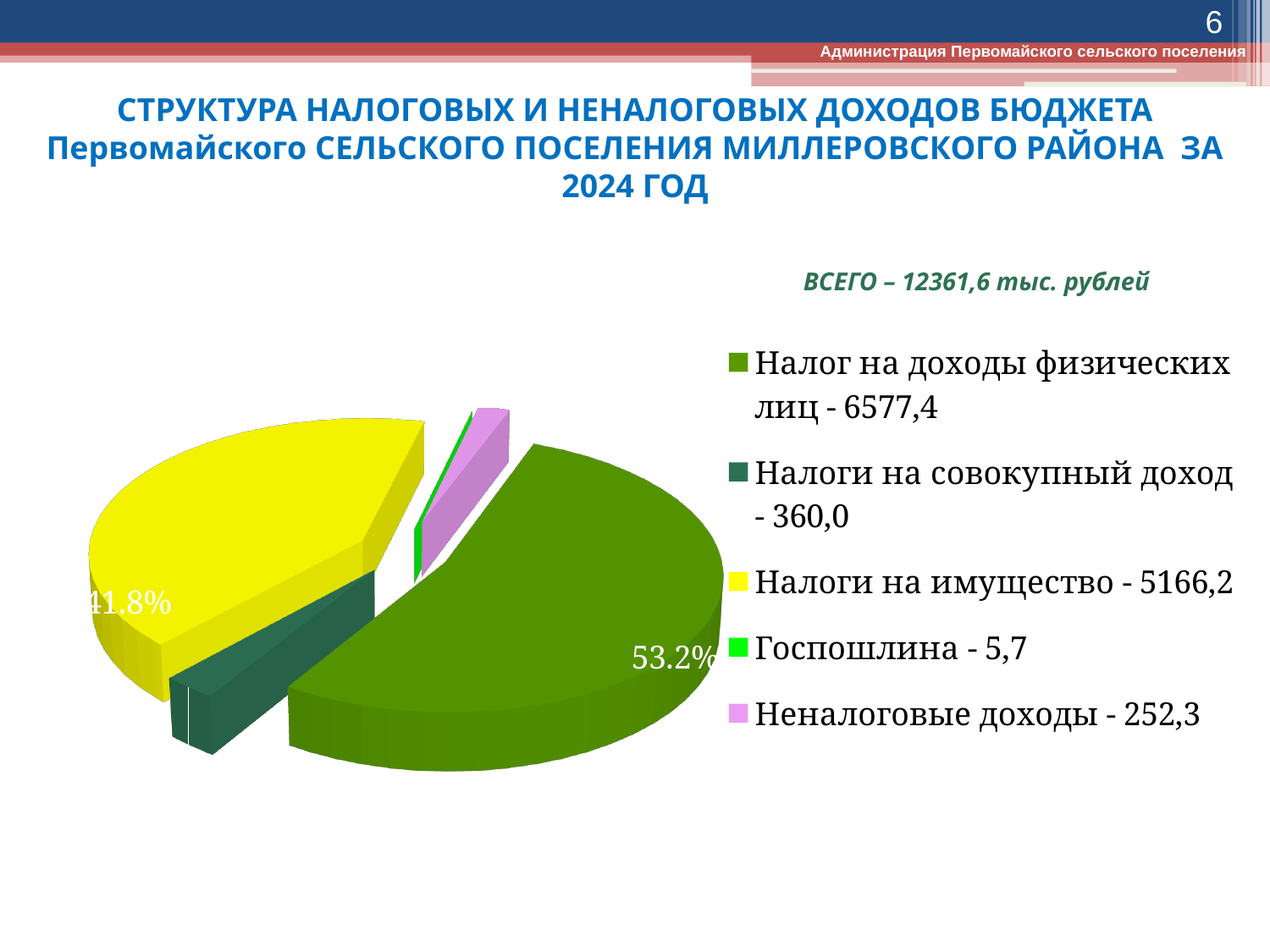
What is the value for Налог на доходы физических лиц? 6577,4 Which category has the smallest share of the pie? Госпошлина Which category has the largest share of the pie? Налог на доходы физических лиц What is the difference between the values for Налог на доходы физических лиц and Налоги на имущество? 1411,2 What kind of chart is shown on the slide? pie chart What is the value for Налоги на имущество? 5166,2 What share of the pie does Налог на доходы физических лиц represent, according to the data label? 53.2% What is the value for Госпошлина? 5,7 How many categories does the pie chart's legend list? 5 What is the value for Налоги на совокупный доход? 360,0 What is the value for Неналоговые доходы? 252,3 What total (ВСЕГО) is stated on the slide for the pie chart? 12361,6 тыс. рублей